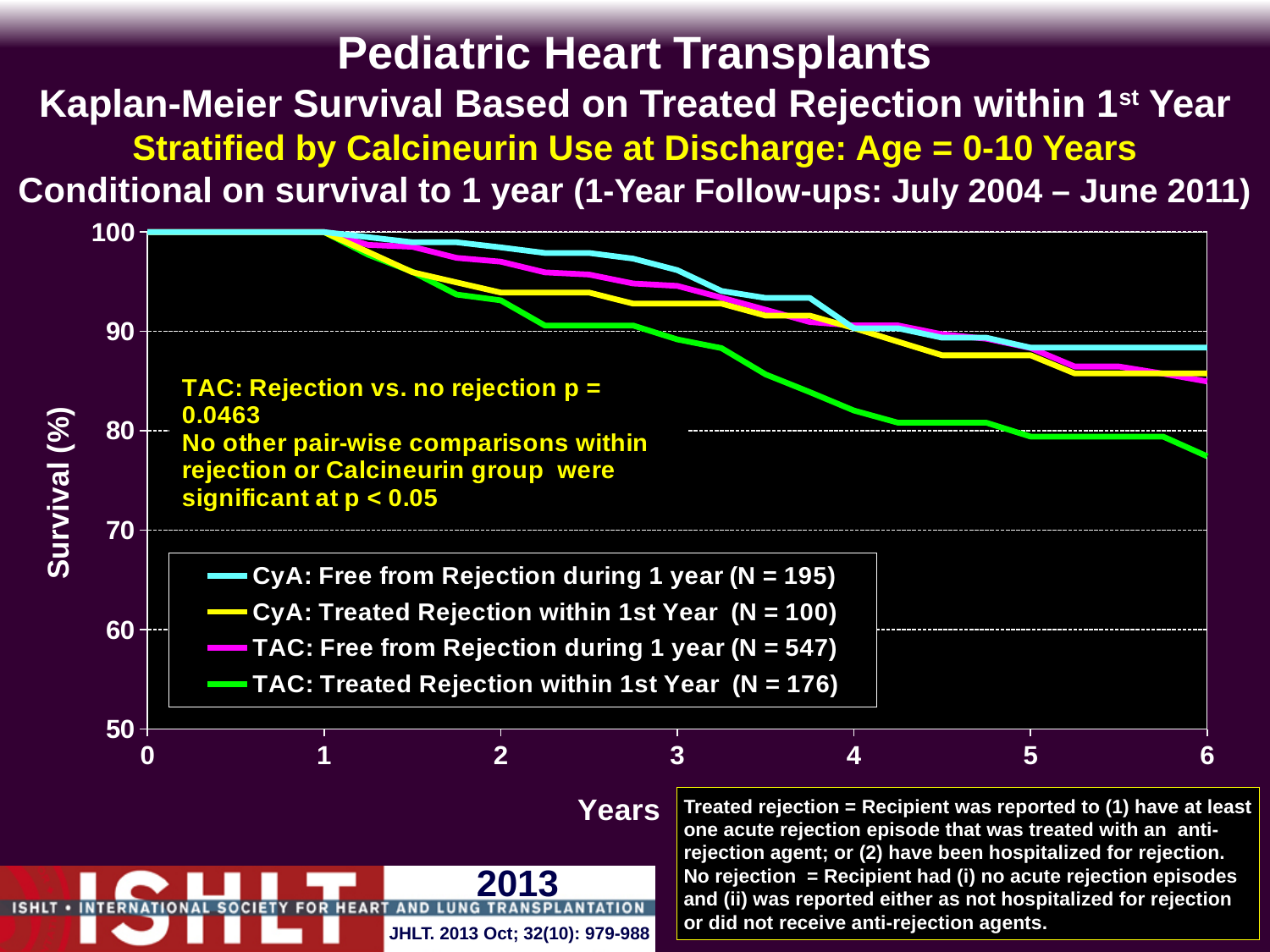
What is the survival (%) for all four groups at year 0? 100 Is the survival for CyA: Free from Rejection during 1 year at year 3 greater or less than 90? greater What is the N for the TAC: Free from Rejection during 1 year group in the legend? 547 Which group has the lowest survival at year 6? TAC: Treated Rejection within 1st Year (N = 176) At year 5, which has higher survival: CyA: Free from Rejection during 1 year or TAC: Treated Rejection within 1st Year? CyA: Free from Rejection during 1 year What p-value is reported for TAC: Rejection vs. no rejection? 0.0463 Is the survival for TAC: Free from Rejection during 1 year at year 6 greater or less than 80? greater Is the survival for TAC: Treated Rejection within 1st Year at year 6 greater or less than 80? less What kind of chart is shown on the slide? Line chart How many series does the legend list? 4 Which group has the highest survival at year 6? CyA: Free from Rejection during 1 year (N = 195) Do the survival curves rise or fall as years increase? Fall